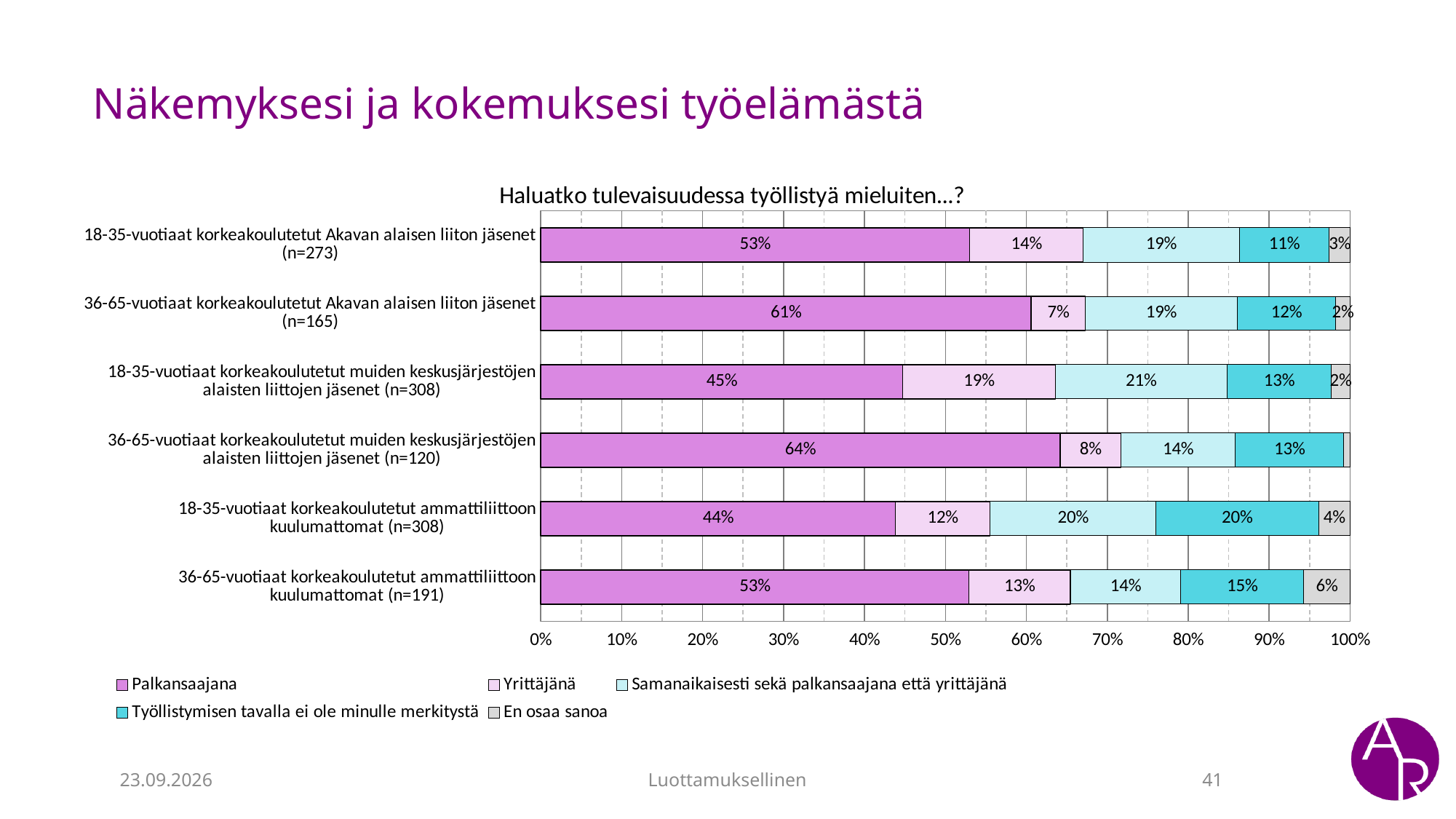
What is the Yrittäjänä share for 18-35-vuotiaat korkeakoulutetut muiden keskusjärjestöjen alaisten liittojen jäsenet (n=308)? 19% Which group has the highest Palkansaajana share? 36-65-vuotiaat korkeakoulutetut muiden keskusjärjestöjen alaisten liittojen jäsenet (n=120) What kind of chart is shown on the slide? Stacked bar chart Which group has the lowest Yrittäjänä share? 36-65-vuotiaat korkeakoulutetut Akavan alaisen liiton jäsenet (n=165) What is the 'En osaa sanoa' share for 36-65-vuotiaat korkeakoulutetut ammattiliittoon kuulumattomat (n=191)? 6% Which is larger: the 'Samanaikaisesti sekä palkansaajana että yrittäjänä' share for 18-35-vuotiaat korkeakoulutetut muiden keskusjärjestöjen alaisten liittojen jäsenet (n=308) or for 36-65-vuotiaat korkeakoulutetut ammattiliittoon kuulumattomat (n=191)? 18-35-vuotiaat korkeakoulutetut muiden keskusjärjestöjen alaisten liittojen jäsenet (n=308) How many series does the legend list? 5 What is the title of the chart? Haluatko tulevaisuudessa työllistyä mieluiten...? What is the 'Työllistymisen tavalla ei ole minulle merkitystä' share for 18-35-vuotiaat korkeakoulutetut ammattiliittoon kuulumattomat (n=308)? 20% What is the Palkansaajana share for 36-65-vuotiaat korkeakoulutetut Akavan alaisen liiton jäsenet (n=165)? 61% What is the difference in Palkansaajana share between 36-65-vuotiaat korkeakoulutetut muiden keskusjärjestöjen alaisten liittojen jäsenet (n=120) and 18-35-vuotiaat korkeakoulutetut ammattiliittoon kuulumattomat (n=308)? 20 percentage points How many respondent groups (categories) are shown in the chart? 6